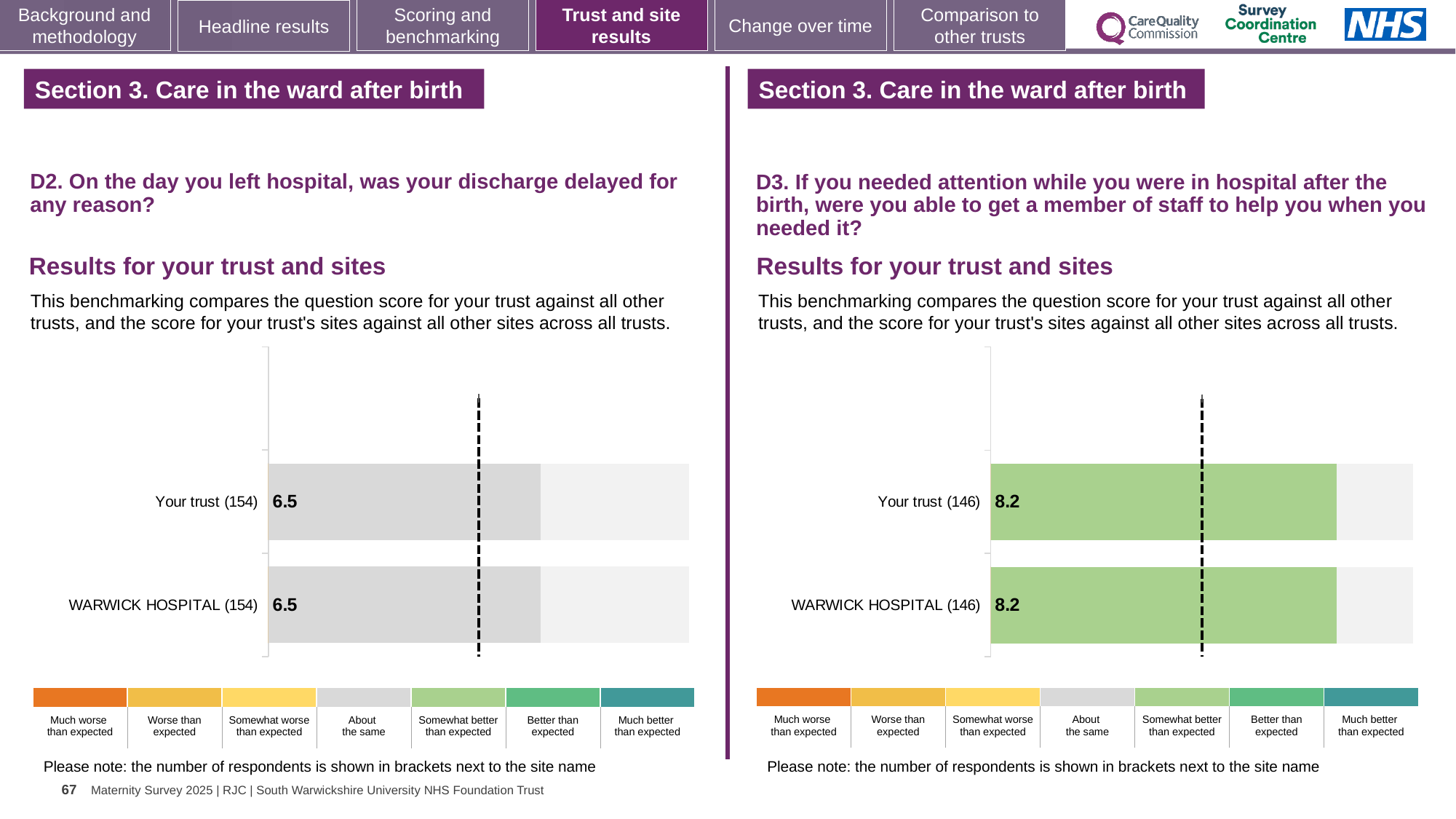
On the D2 chart (left), what is the score for Your trust? 6.5 On the D2 chart (left), how many respondents are shown in brackets next to Your trust? 154 On the D2 chart (left), what is the score for WARWICK HOSPITAL? 6.5 On the D3 chart (right), what is the score for WARWICK HOSPITAL? 8.2 What kind of chart is used on the D3 chart (right)? Bar chart On the D3 chart (right), what is the difference between the score for Your trust and the score for WARWICK HOSPITAL? 0 On the D3 chart (right), what is the score for Your trust? 8.2 How many bars are plotted on the D2 chart (left)? 2 On the D2 chart (left), what is the difference between the score for Your trust and the score for WARWICK HOSPITAL? 0 How many bars are plotted on the D3 chart (right)? 2 On the D2 chart (left), which benchmarking category does the colour of the bars correspond to in the legend? About the same On the D3 chart (right), which benchmarking category does the colour of the bars correspond to in the legend? Somewhat better than expected